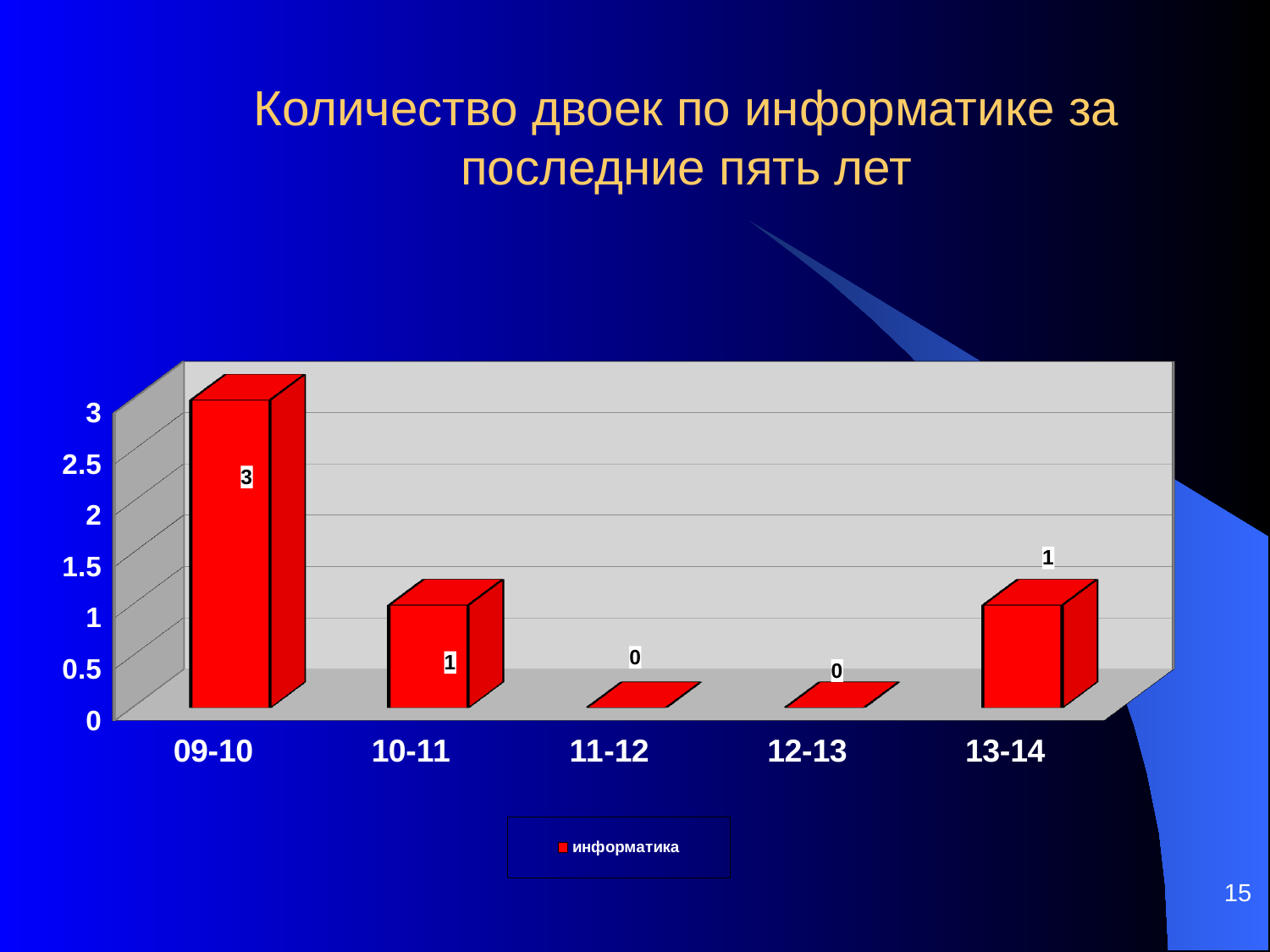
What is the difference between the values for 09-10 and 10-11? 2 How many series does the legend list? 1 What kind of chart is shown on the slide? bar chart Which is larger, the value for 09-10 or the value for 13-14? 09-10 How many categories are shown on the x axis? 5 What is the value for 10-11? 1 Which category has the highest value? 09-10 What is the value for 09-10? 3 What is the value for 11-12? 0 Is the value for 09-10 greater or less than 2? greater What is the value for 13-14? 1 What is the title of the chart on the slide? Количество двоек по информатике за последние пять лет